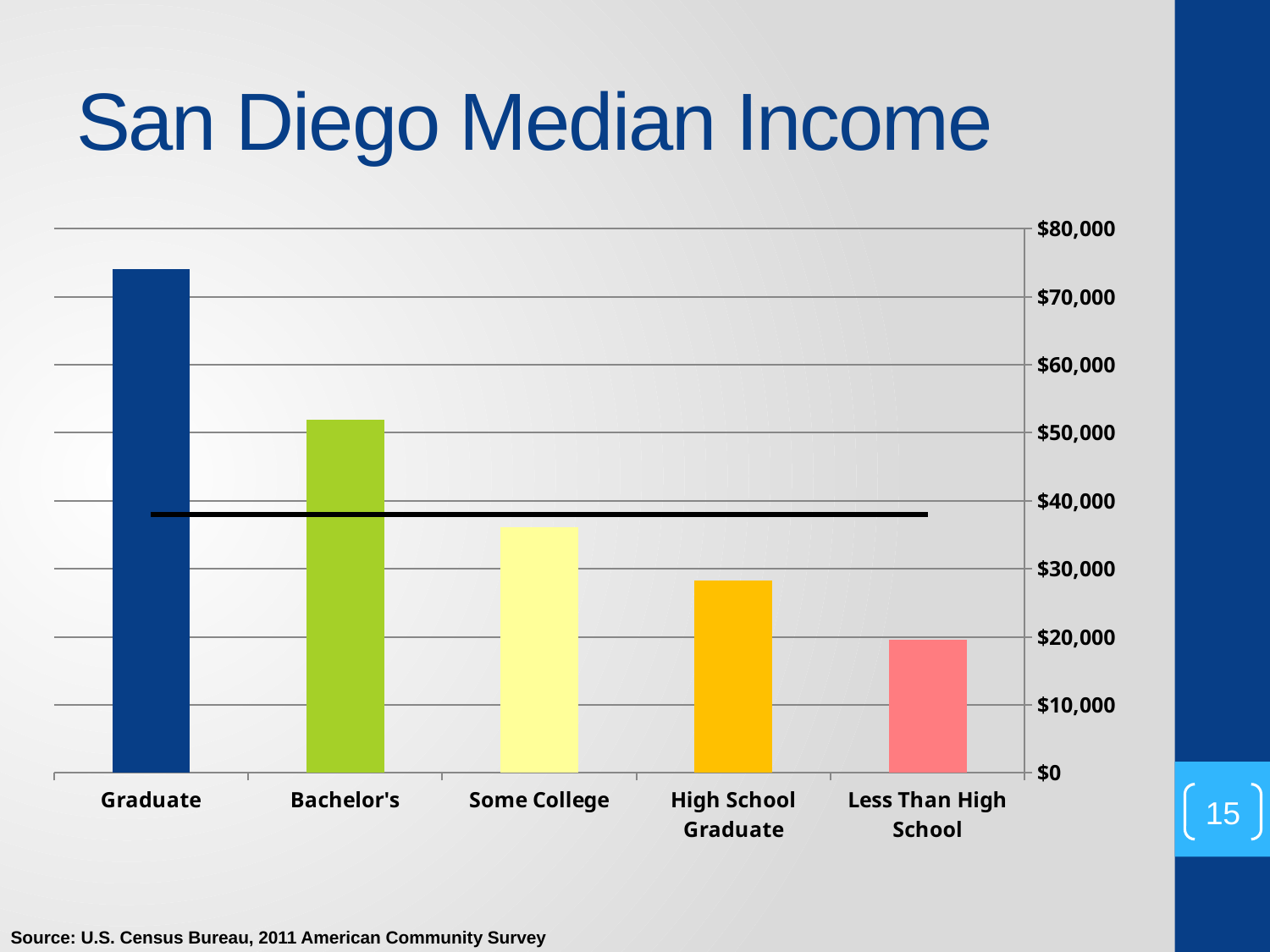
How many education categories are shown on the x axis? 5 Which education category has the highest median income? Graduate Is the median income for Graduate greater or less than $70,000? greater Which education category has the lowest median income? Less Than High School What kind of chart is shown on the slide? bar chart What is the title of the slide containing the chart? San Diego Median Income Is the median income for Some College greater or less than $40,000? less Do the median income values rise or fall moving from Graduate to Less Than High School along the x axis? fall Which has a higher median income, High School Graduate or Less Than High School? High School Graduate Which has a higher median income, Bachelor's or Some College? Bachelor's Is the median income for Bachelor's greater or less than $50,000? greater